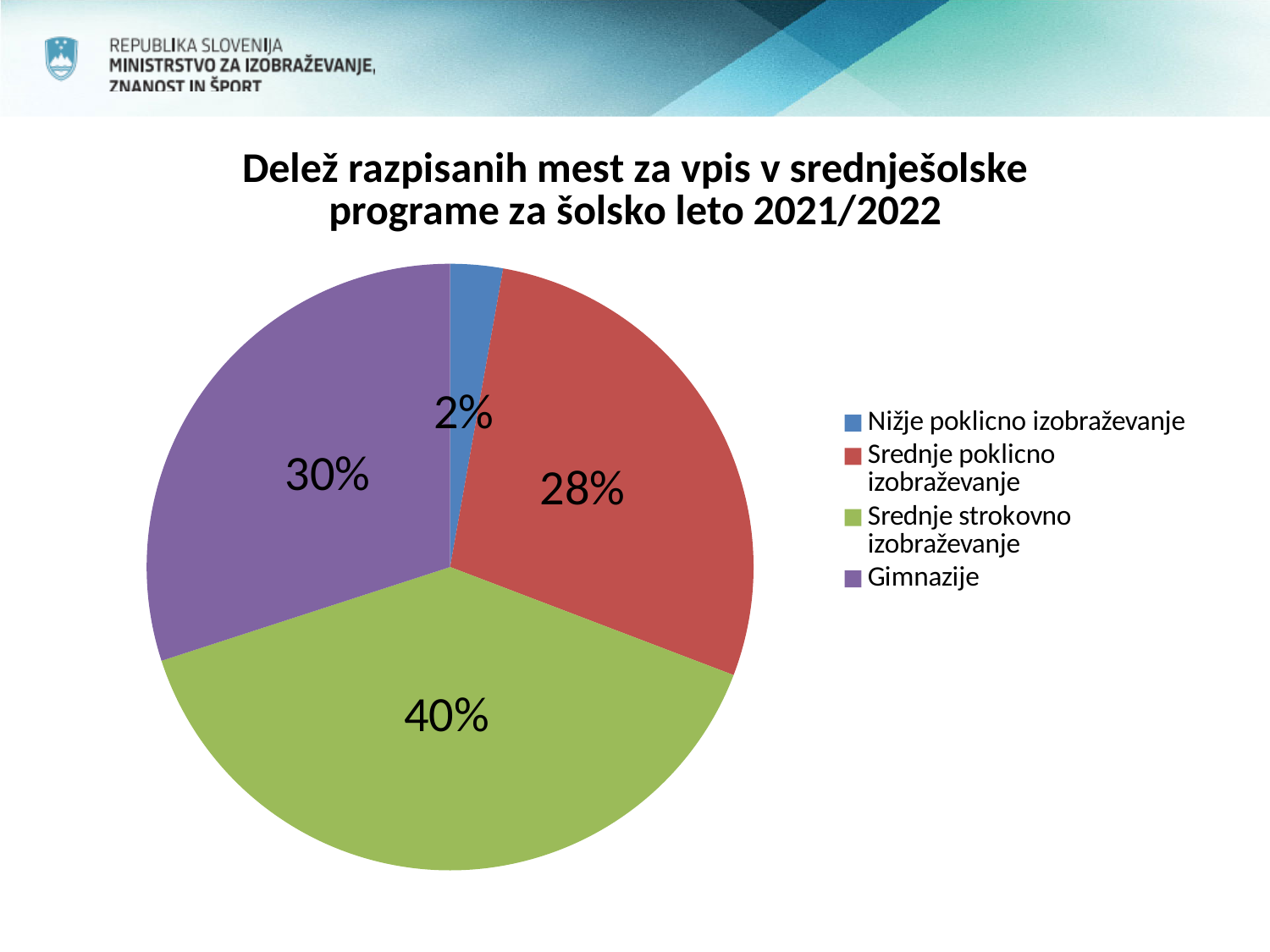
What share of the pie does Srednje strokovno izobraževanje have? 40% What is the difference in percentage points between Srednje strokovno izobraževanje and Gimnazije? 10 What kind of chart is shown on the slide? Pie chart What share of the pie does Srednje poklicno izobraževanje have? 28% What share of the pie does Gimnazije have? 30% What colour is the slice for Gimnazije? Purple What is the difference in percentage points between Srednje poklicno izobraževanje and Nižje poklicno izobraževanje? 26 Which category has the smallest slice of the pie? Nižje poklicno izobraževanje How many categories does the pie chart show? 4 Which is larger, the share for Gimnazije or the share for Srednje poklicno izobraževanje? Gimnazije Which category has the largest slice of the pie? Srednje strokovno izobraževanje